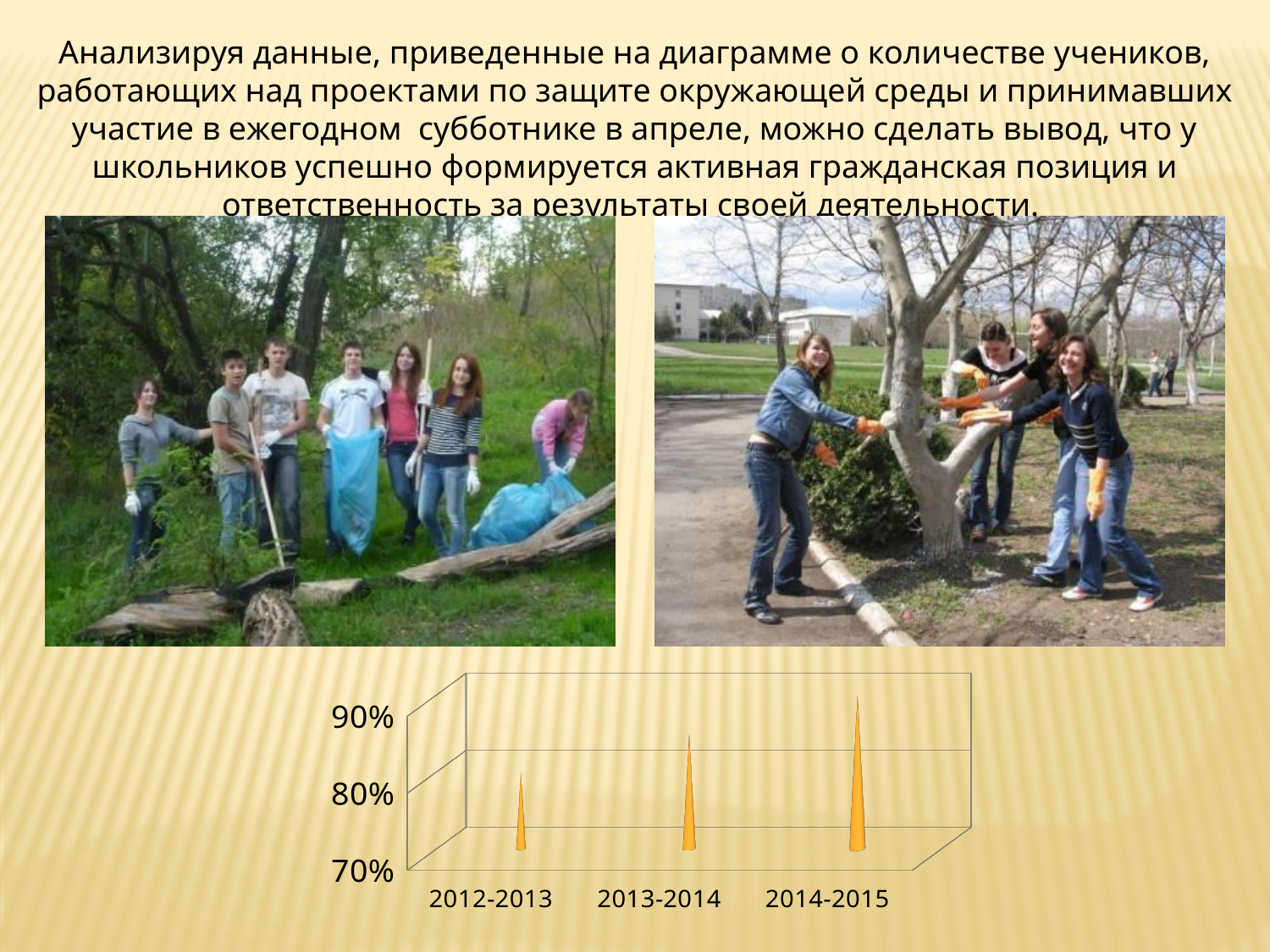
Which is larger, the value for 2014-2015 or the value for 2013-2014? 2014-2015 What kind of chart is shown at the bottom of the slide? bar chart Which category has the lowest value in the chart? 2012-2013 What is the lowest value labelled on the vertical axis of the chart? 70% Is the value for 2012-2013 greater or less than 90%? less Which category has the highest value in the chart? 2014-2015 How many categories are shown on the x axis of the chart? 3 Do the values in the chart rise or fall from 2012-2013 to 2014-2015? rise Which is larger, the value for 2013-2014 or the value for 2012-2013? 2013-2014 Is the value for 2013-2014 greater or less than 80%? greater What colour are the bars in the chart? orange Is the value for 2014-2015 greater or less than 80%? greater